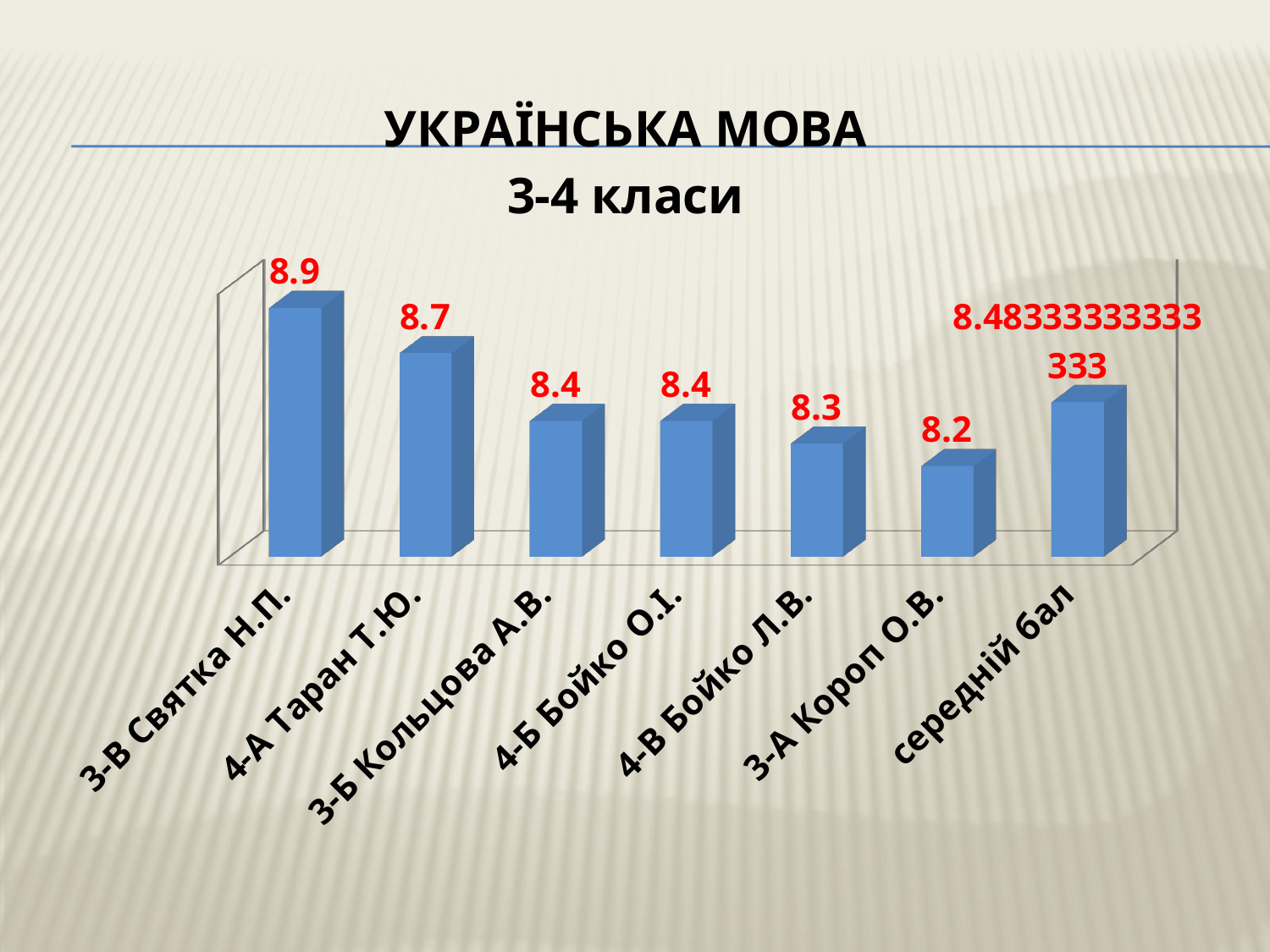
How many bars are shown in the chart? 7 Which category has the lowest value? 3-А Короп О.В. What is the value shown for середній бал? 8.48333333333333 What is the value for 4-В Бойко Л.В.? 8.3 What is the value for 3-А Короп О.В.? 8.2 Which is larger, the value for 4-А Таран Т.Ю. or the value for 4-В Бойко Л.В.? 4-А Таран Т.Ю. What is the value for 4-А Таран Т.Ю.? 8.7 What is the value for 3-В Святка Н.П.? 8.9 What is the difference between the values for 3-В Святка Н.П. and 3-А Короп О.В.? 0.7 What is the difference between the values for 4-А Таран Т.Ю. and 4-Б Бойко О.І.? 0.3 What kind of chart is shown on the slide? Bar chart Which category has the highest value? 3-В Святка Н.П.